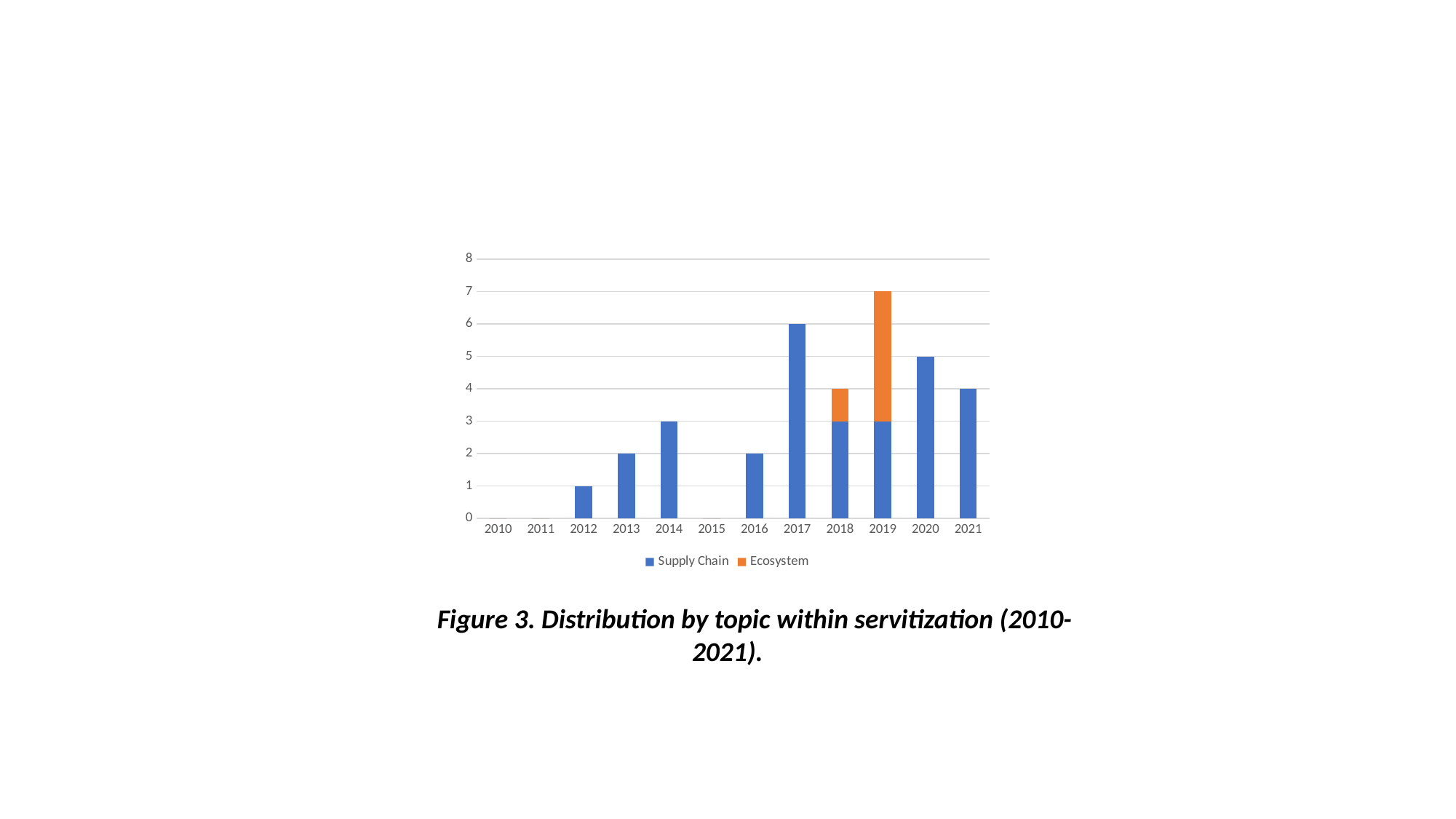
What is the total height of the stacked bar for 2018? 4 How many series does the legend list? 2 What is the total height of the stacked bar for 2019? 7 Which series is shown in orange? Ecosystem Is the Supply Chain value for 2017 greater or less than 5? greater How many years are shown on the x axis? 12 What is the Supply Chain value for 2014? 3 Which year has the highest Supply Chain value? 2017 Which year has the tallest stacked bar? 2019 What is the Supply Chain value for 2017? 6 What kind of chart is shown on the slide? Stacked bar chart What is the difference between the Supply Chain values for 2020 and 2021? 1